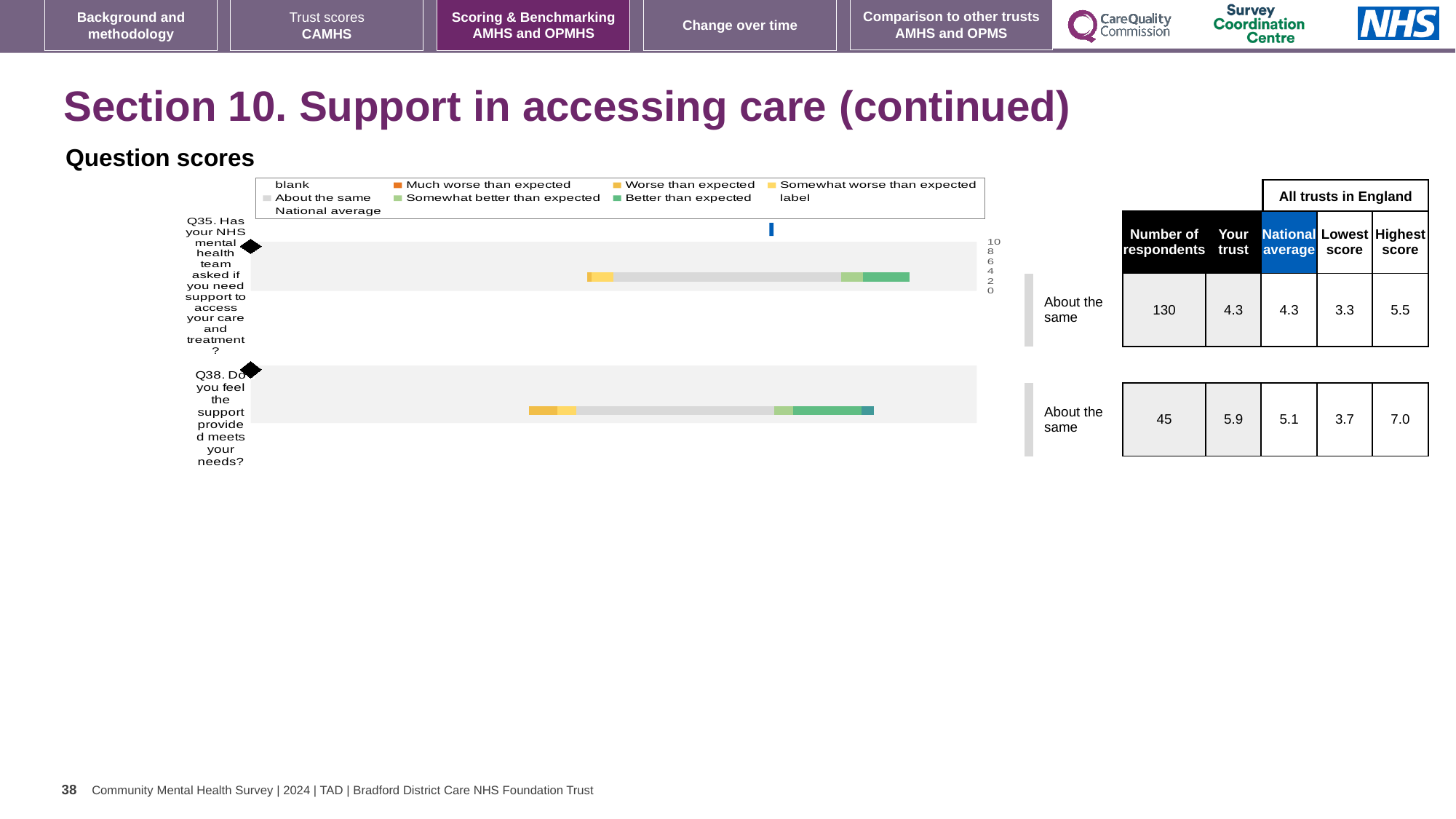
What is the national average score for Q38? 5.1 What is the 'Your trust' score for Q38 (Do you feel the support provided meets your needs?)? 5.9 What benchmark category is shown for Q35? About the same How many respondents answered Q35? 130 What is the 'Your trust' score for Q35 (Has your NHS mental health team asked if you need support to access your care and treatment?)? 4.3 How many questions are plotted in the question scores chart? 2 For Q38, which is larger: the 'Your trust' score or the national average? Your trust In the chart legend, what does the light grey colour represent? About the same Which question has the higher 'Your trust' score, Q35 or Q38? Q38 What is the difference between the highest score and the lowest score for Q38? 3.3 In the chart legend, what does the orange colour represent? Much worse than expected What kind of chart is used to show the question scores on this slide? bar chart